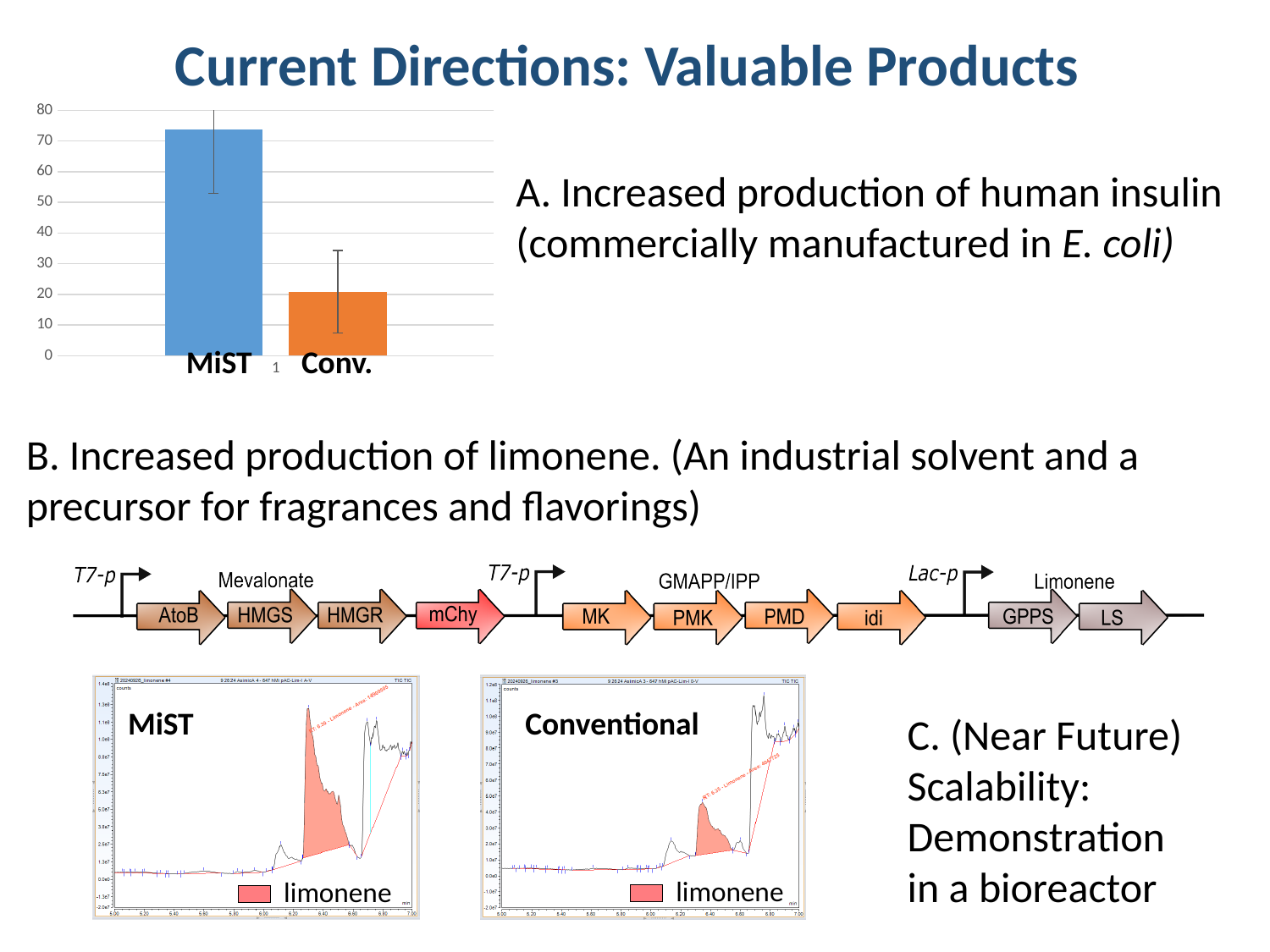
In the bar chart at the top left, is the value for Conv. greater or less than 10? greater In the bar chart at the top left, what colour is the bar for Conv.? orange In the bar chart at the top left, which category has the highest value? MiST In the bar chart at the top left, is the value for MiST greater or less than 80? less What kind of chart is shown at the top left of the slide? bar chart In the bar chart at the top left, is the value for MiST greater or less than 60? greater In the bar chart at the top left, what is the highest value shown on the vertical axis? 80 In the bar chart at the top left, which is larger, the value for MiST or the value for Conv.? MiST In the bar chart at the top left, which category has the lowest value? Conv. How many bars are plotted in the bar chart at the top left of the slide? 2